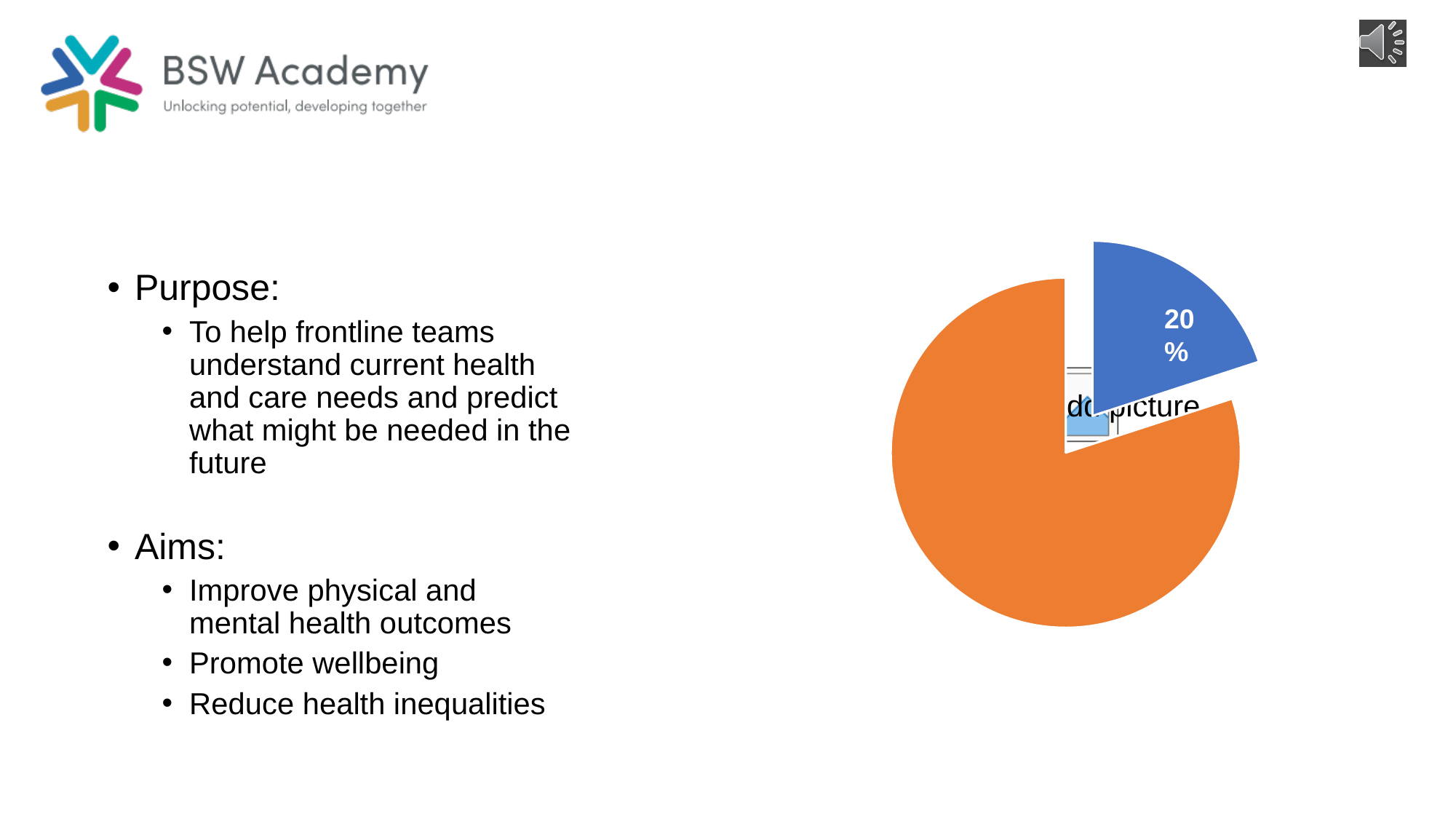
What colour is the slice of the pie chart labelled 20%? blue Which slice of the pie chart is the smallest, the orange one or the blue one? blue What percentage is printed on the blue slice of the pie chart? 20% Which slice of the pie chart is pulled out (exploded) from the rest of the pie? the blue slice What kind of chart is shown on the right of the slide? pie chart How many slices does the pie chart have? 2 Which slice of the pie chart is the largest, the orange one or the blue one? orange Is the orange slice of the pie chart larger or smaller than the blue slice? larger